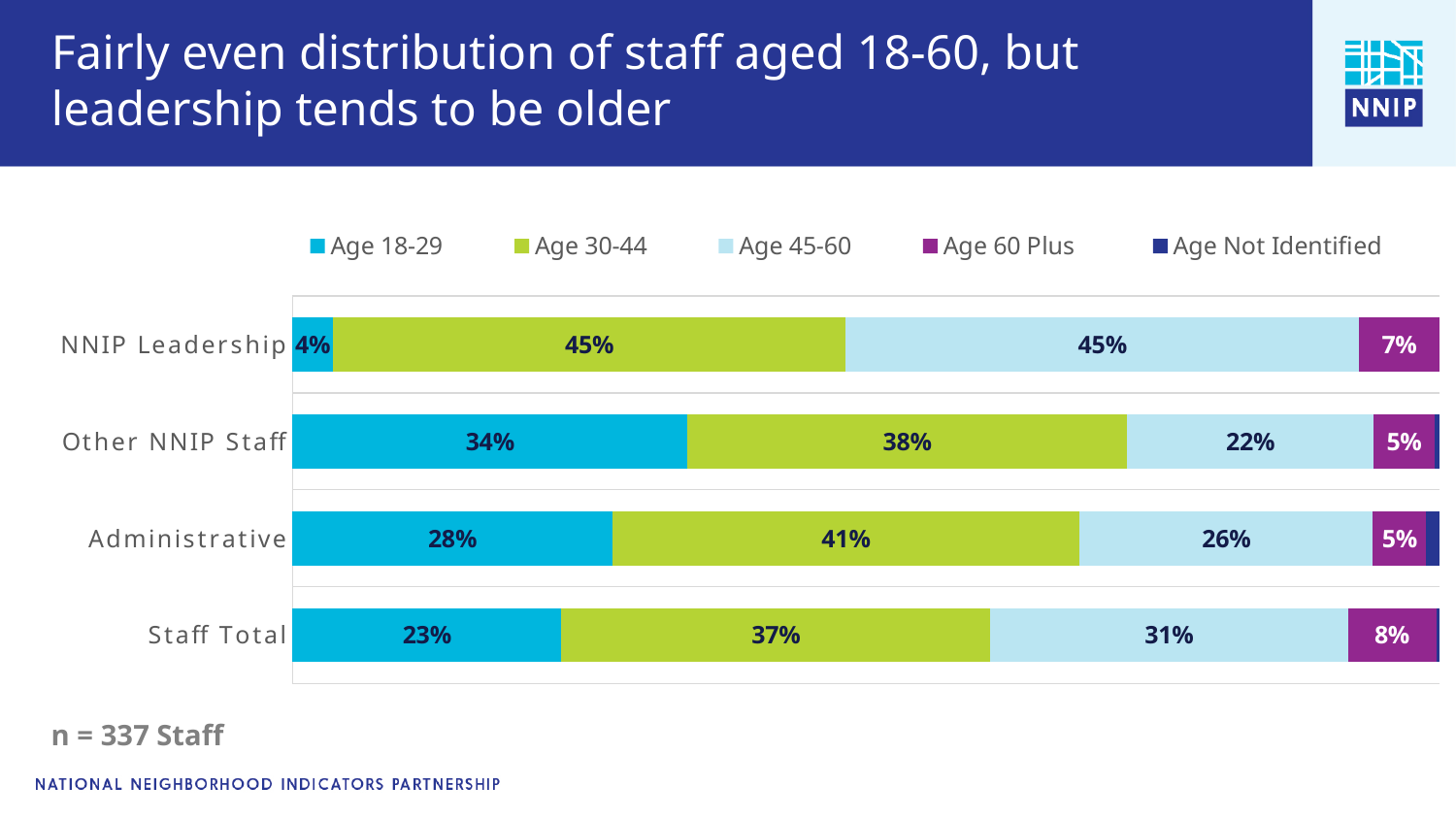
Which staff group has the highest Age 18-29 percentage? Other NNIP Staff How many age series does the legend list? 5 What is the difference between the Age 30-44 percentages for Administrative and Other NNIP Staff? 3% What percentage of NNIP Leadership is aged 30-44? 45% What is the sample size noted below the chart? n = 337 Staff How many staff groups are shown on the chart? 4 What kind of chart is shown on the slide? Stacked bar chart What is the Age 45-60 value for Administrative staff? 26% What percentage of Other NNIP Staff is aged 18-29? 34% Which staff group has the lowest Age 18-29 percentage? NNIP Leadership Which is larger: the Age 45-60 share for NNIP Leadership or for Staff Total? NNIP Leadership What share of Staff Total is Age 60 Plus? 8%